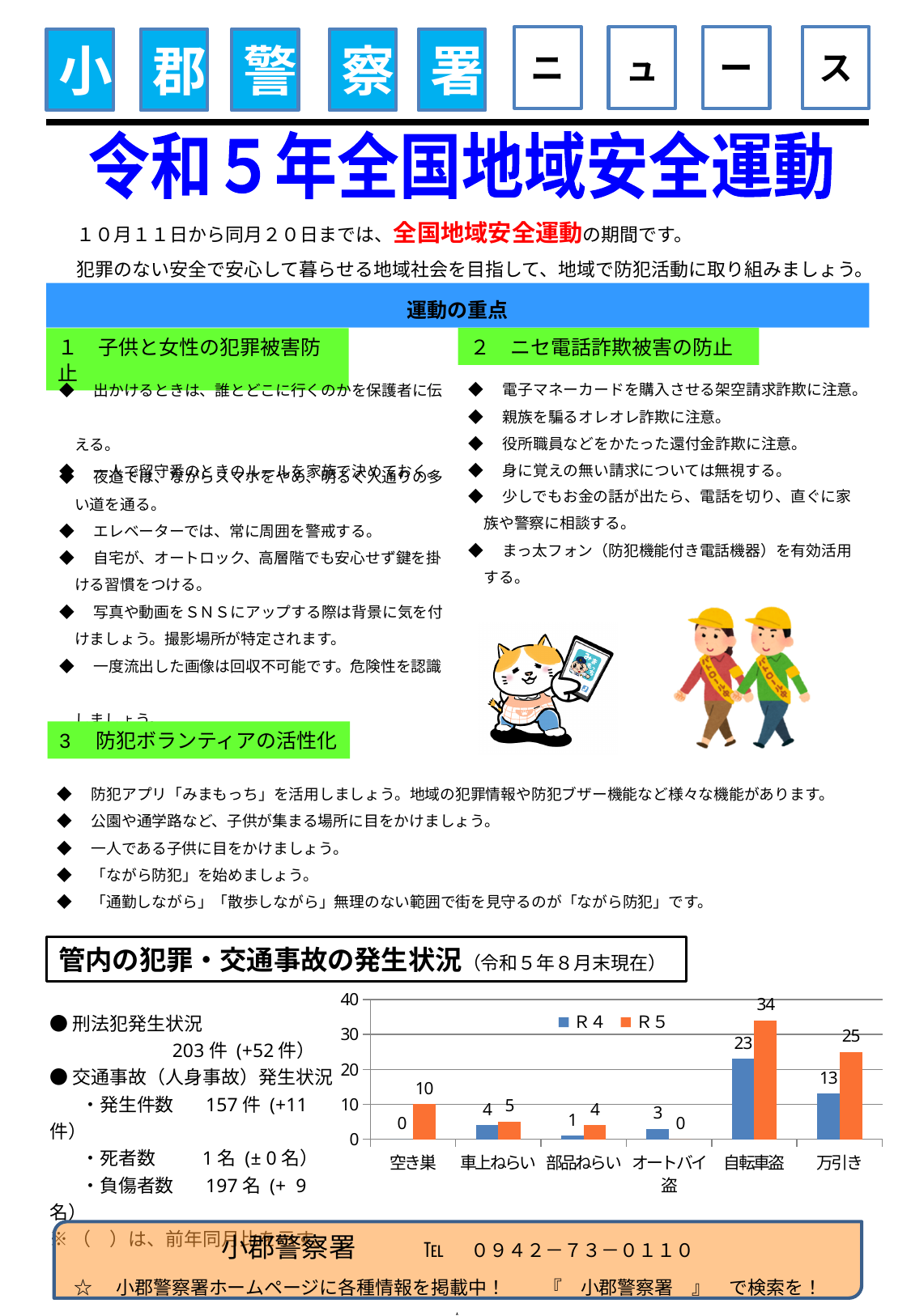
Which category has the lowest R4 value? 空き巣 What is the difference between the R5 and R4 values for 自転車盗? 11 What is the R5 value for 空き巣? 10 How many series does the chart legend list? 2 Which colour represents the R5 series in the chart? orange Which is larger for オートバイ盗, the R4 value or the R5 value? R4 What is the difference between the R5 and R4 values for 万引き? 12 What is the R4 value for 万引き? 13 How many categories are shown on the x axis of the chart? 6 Which category has the highest R5 value? 自転車盗 What kind of chart is shown on the slide? bar chart What is the R5 value for 自転車盗? 34